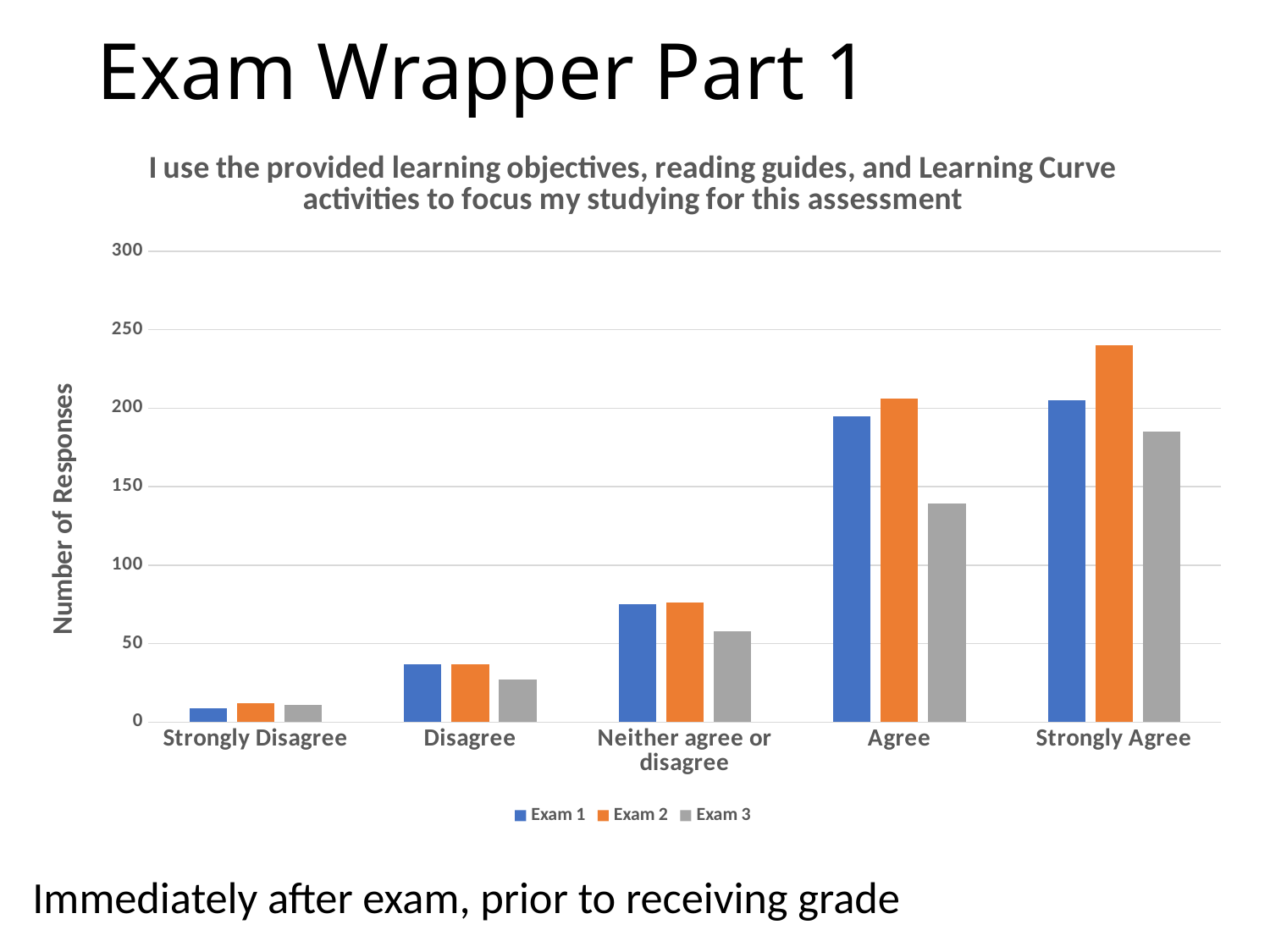
How many series does the legend list? 3 What is the label of the y axis? Number of Responses Is the value for Exam 3 in the Disagree category greater or less than 50? less Which response category has the lowest value for Exam 3? Strongly Disagree How many response categories are shown on the x axis? 5 Which colour represents Exam 3 in the legend? grey Is the value for Exam 3 in the Agree category greater or less than 150? less In the Agree category, which is larger: Exam 2 or Exam 3? Exam 2 Which response category has the highest value for Exam 2? Strongly Agree Is the value for Exam 2 in the Strongly Agree category greater or less than 200? greater What kind of chart is shown on the slide? bar chart